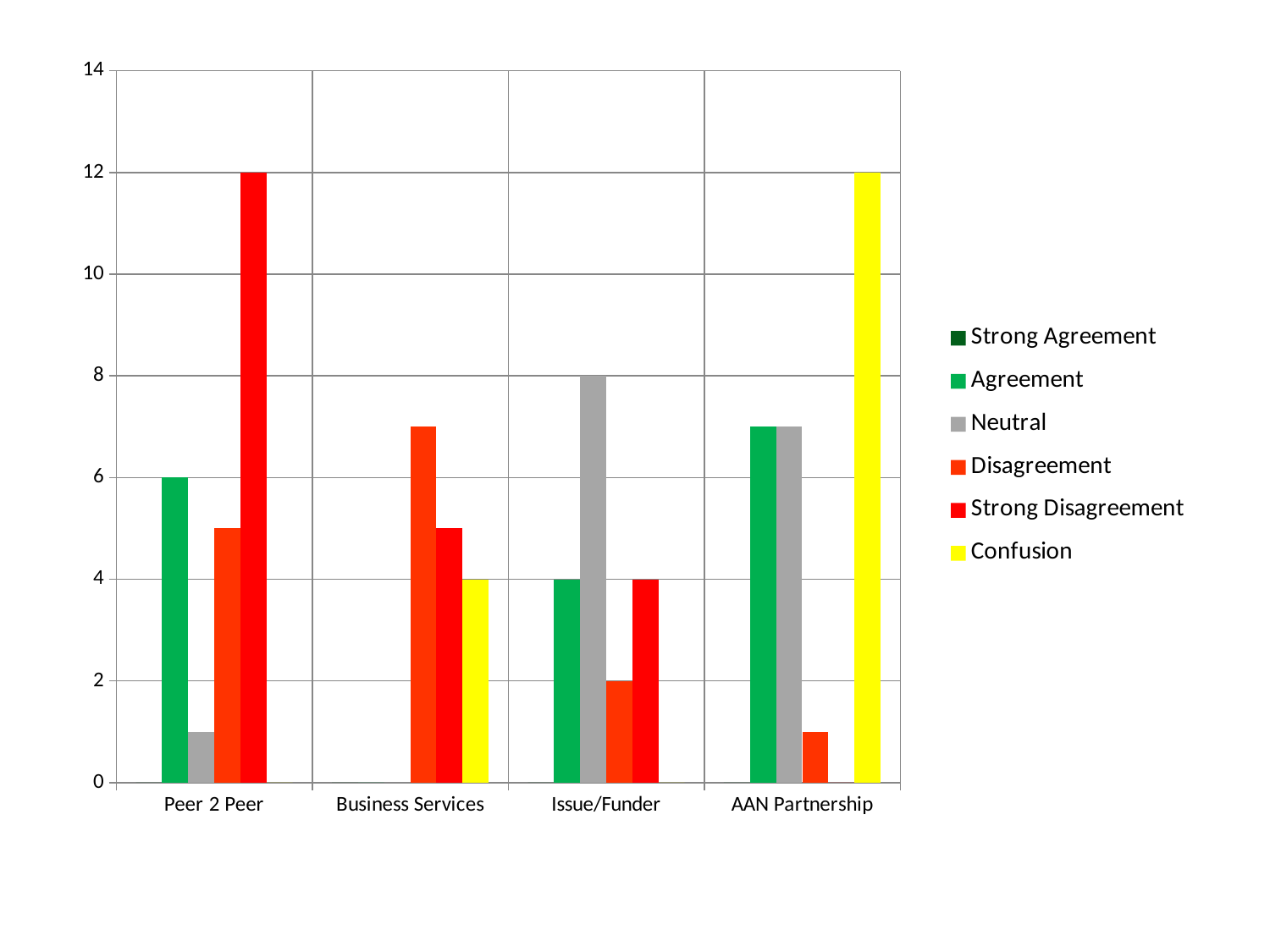
What kind of chart is shown on the slide? bar chart What is the Disagreement value for Issue/Funder? 2 What is the difference between the Strong Disagreement and Agreement values for Peer 2 Peer? 6 Is the Disagreement value for Business Services greater or less than 6? greater Which series has the highest value for Peer 2 Peer? Strong Disagreement What is the Neutral value for Issue/Funder? 8 What is the Agreement value for Peer 2 Peer? 6 How many categories are shown on the x axis? 4 What is the Strong Disagreement value for Peer 2 Peer? 12 For Issue/Funder, which is larger: Neutral or Agreement? Neutral How many series does the legend list? 6 What is the Confusion value for AAN Partnership? 12